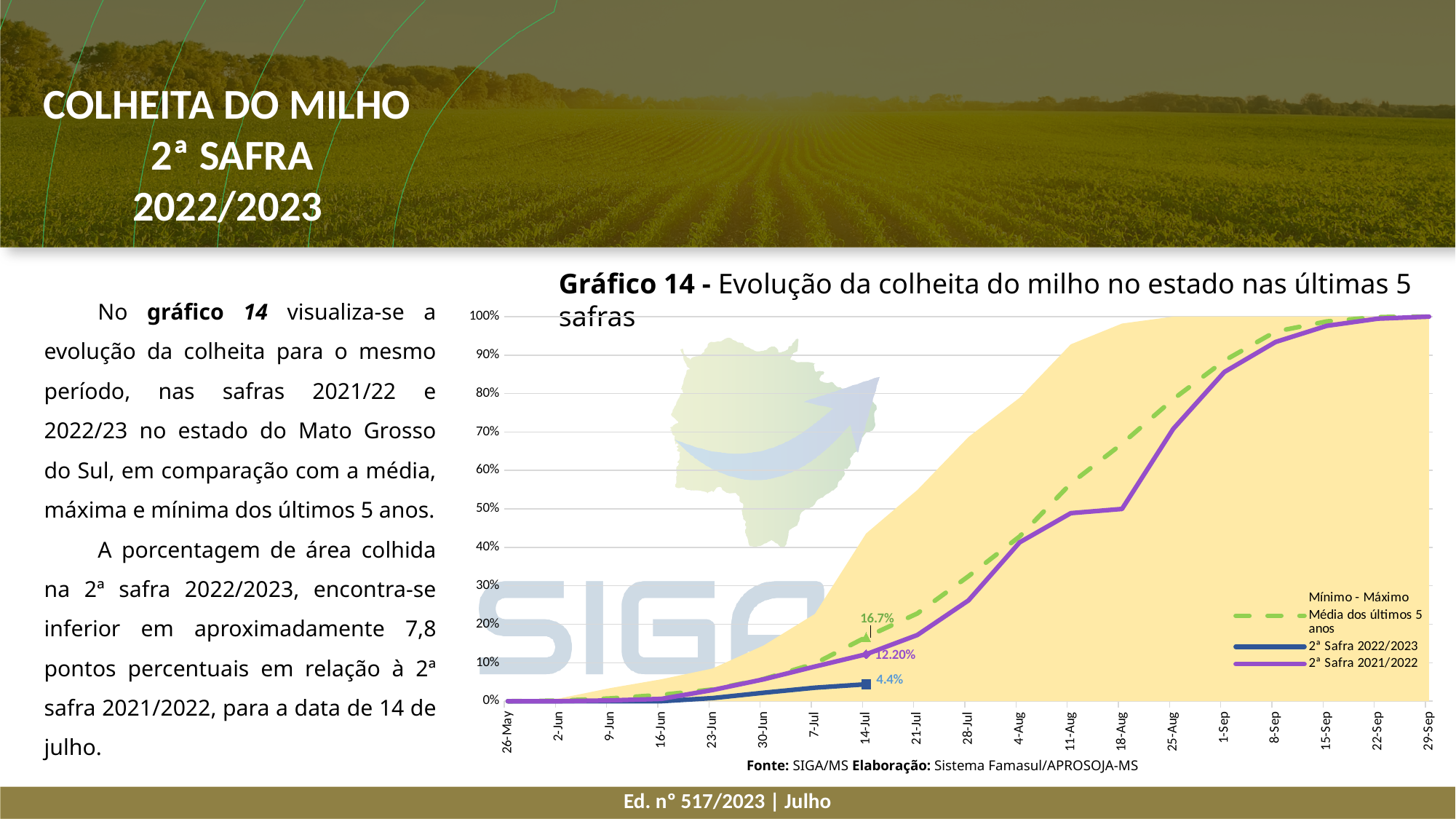
Does the 2ª Safra 2021/2022 line rise or fall from 26-May to 29-Sep? Rise Is the value for 2ª Safra 2021/2022 on 18-Aug greater or less than 40%? greater What is the value for 2ª Safra 2021/2022 on 14-Jul? 12.20% Which labelled series has the highest value on 14-Jul? Média dos últimos 5 anos On 14-Jul, what is the difference between the Média dos últimos 5 anos value and the 2ª Safra 2022/2023 value? 12.3 percentage points How many entries does the legend list? 4 On 14-Jul, what is the difference between the 2ª Safra 2021/2022 value and the 2ª Safra 2022/2023 value? 7.8 percentage points On 14-Jul, which is larger: 2ª Safra 2021/2022 or 2ª Safra 2022/2023? 2ª Safra 2021/2022 Which legend entry is drawn as a dashed green line? Média dos últimos 5 anos What is the value for 2ª Safra 2022/2023 on 14-Jul? 4.4% What is the value for Média dos últimos 5 anos on 14-Jul? 16.7% What kind of chart is Gráfico 14? Combination area and line chart (lines with a shaded min–max area)